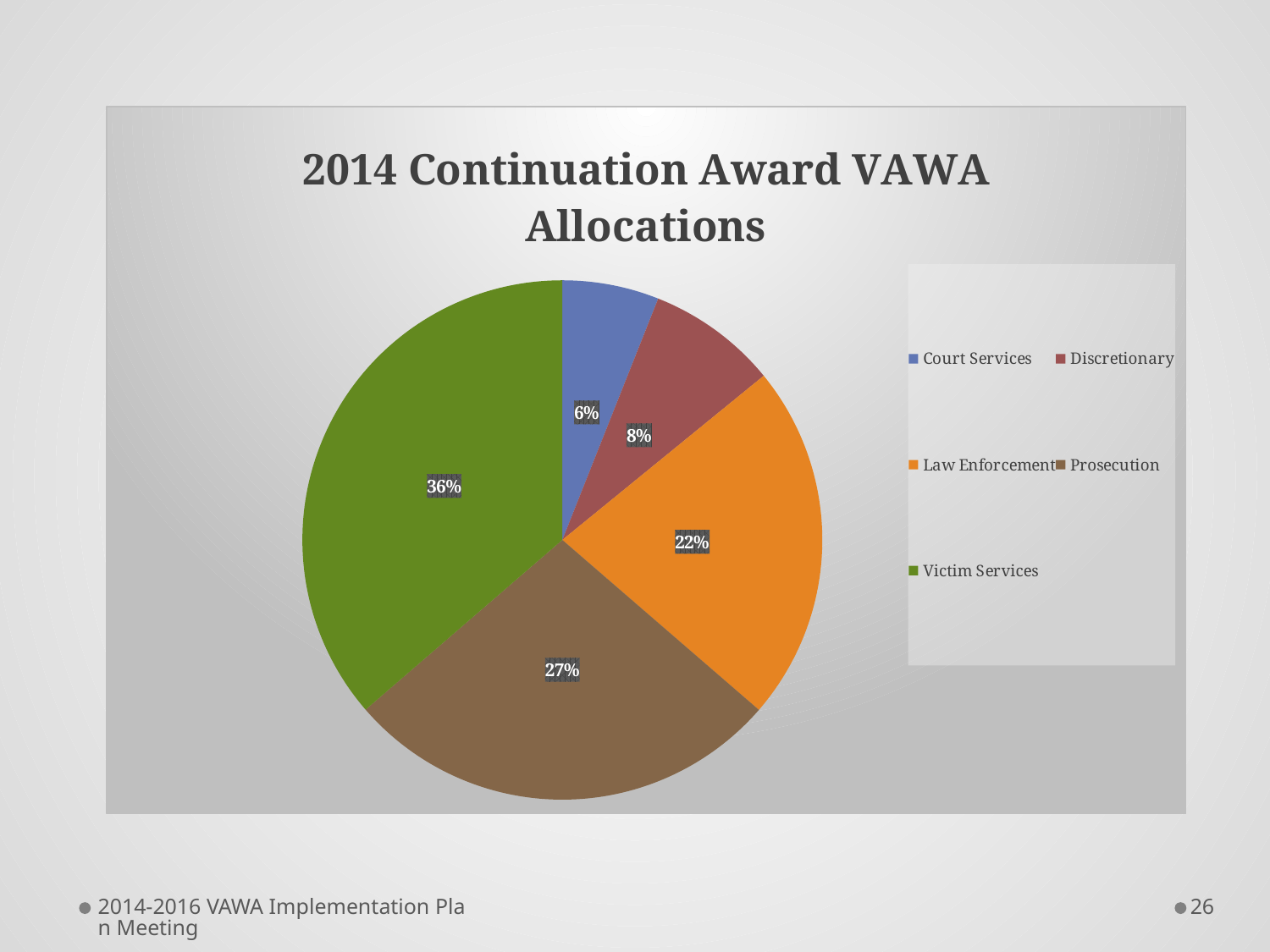
Which category has the largest share of the pie? Victim Services What is the difference between the Victim Services share and the Prosecution share? 9% What share of the pie does Victim Services represent? 36% Which is larger, the share for Law Enforcement or the share for Prosecution? Prosecution What is the value shown for Court Services? 6% How many categories are shown in the pie chart? 5 What is the value shown for Law Enforcement? 22% What kind of chart is shown on the slide? Pie chart What is the title of the chart? 2014 Continuation Award VAWA Allocations Which category has the smallest share of the pie? Court Services What is the value shown for Discretionary? 8% What is the value shown for Prosecution? 27%